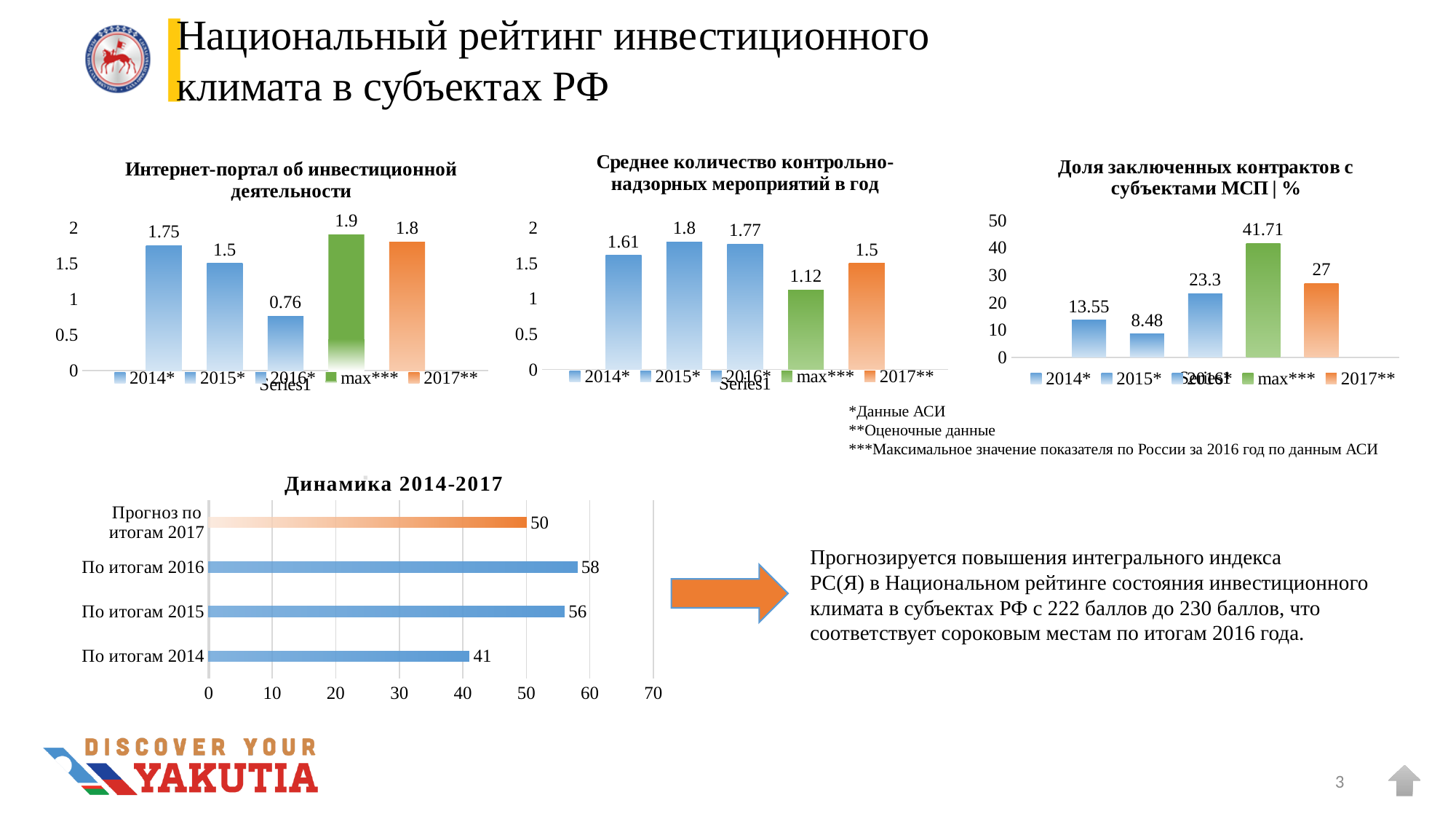
In the chart 'Доля заключенных контрактов с субъектами МСП | %', what is the difference between the 2014* value and the 2015* value? 5.07 In the chart 'Интернет-портал об инвестиционной деятельности', which legend entry has the highest value? max*** In the chart 'Динамика 2014-2017', which category has the lowest value? По итогам 2014 How many bars are shown in the chart 'Динамика 2014-2017'? 4 In the chart 'Доля заключенных контрактов с субъектами МСП | %', what is the value for max***? 41.71 In the chart 'Среднее количество контрольно-надзорных мероприятий в год', which legend entry has the lowest value? max*** In the chart 'Доля заключенных контрактов с субъектами МСП | %', which is larger, the value for 2016* or the value for 2017**? 2017** What kind of chart is 'Динамика 2014-2017'? Bar chart In the chart 'Интернет-портал об инвестиционной деятельности', what is the value for 2016*? 0.76 In the chart 'Динамика 2014-2017', what is the value for 'По итогам 2016'? 58 In the chart 'Среднее количество контрольно-надзорных мероприятий в год', what is the difference between the 2015* value and the 2014* value? 0.19 In the chart 'Среднее количество контрольно-надзорных мероприятий в год', what is the value for 2017**? 1.5